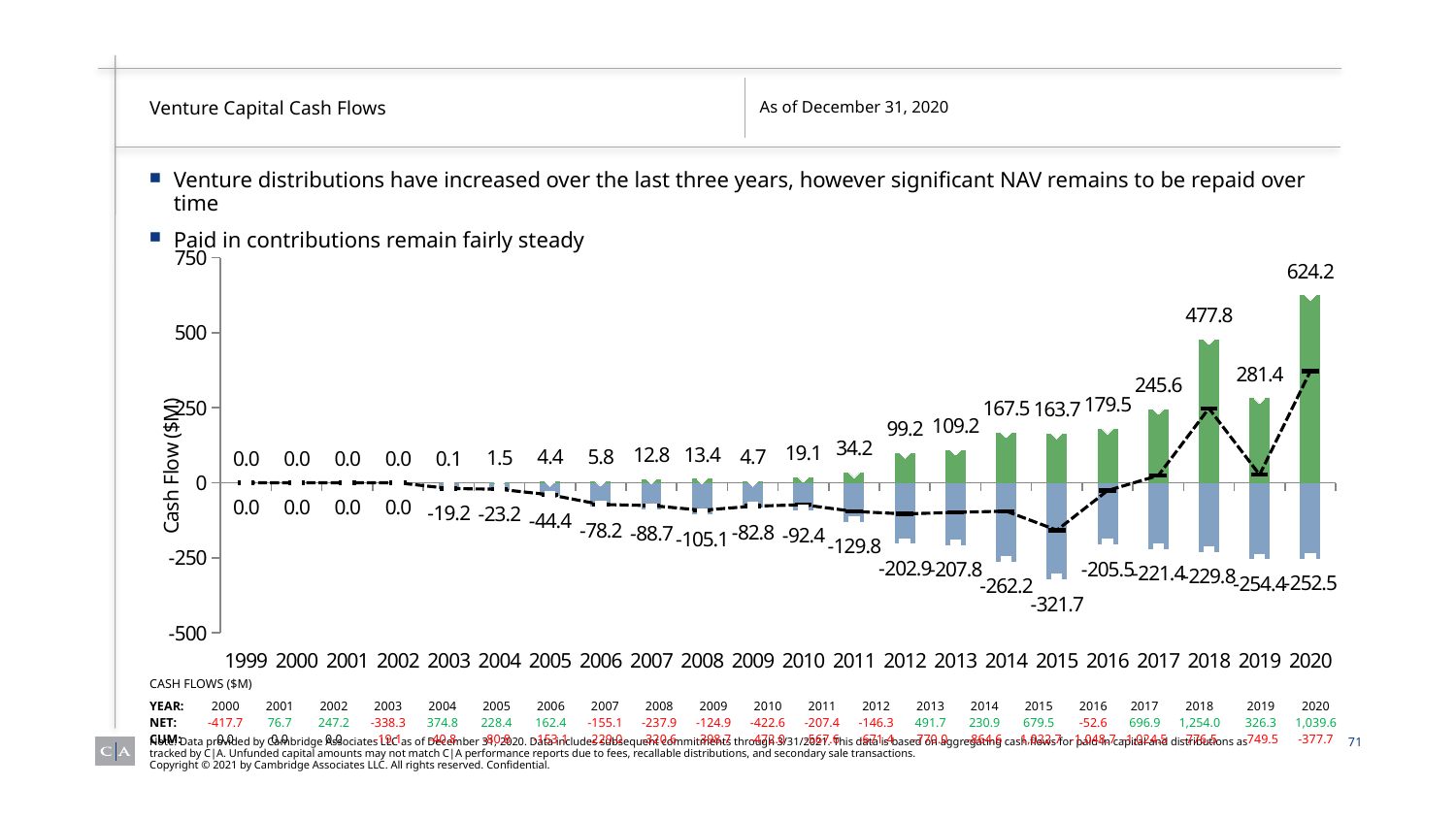
Which year has the lowest (most negative) blue bar? 2015 What is the value of the blue bar for 2015? -321.7 Which year has the highest green bar? 2020 What is the label of the y axis? Cash Flow ($M) What is the value of the green bar for 2018? 477.8 Is the value of the green bar for 2018 greater or less than 250? greater What is the difference between the green bar values for 2020 and 2019? 342.8 Which is larger, the green bar for 2017 or the green bar for 2019? 2019 How many years are shown on the x axis? 22 What type of chart is shown on the slide? Combination bar and line chart What is the value of the blue bar for 2012? -202.9 What is the value of the green bar for 2020? 624.2